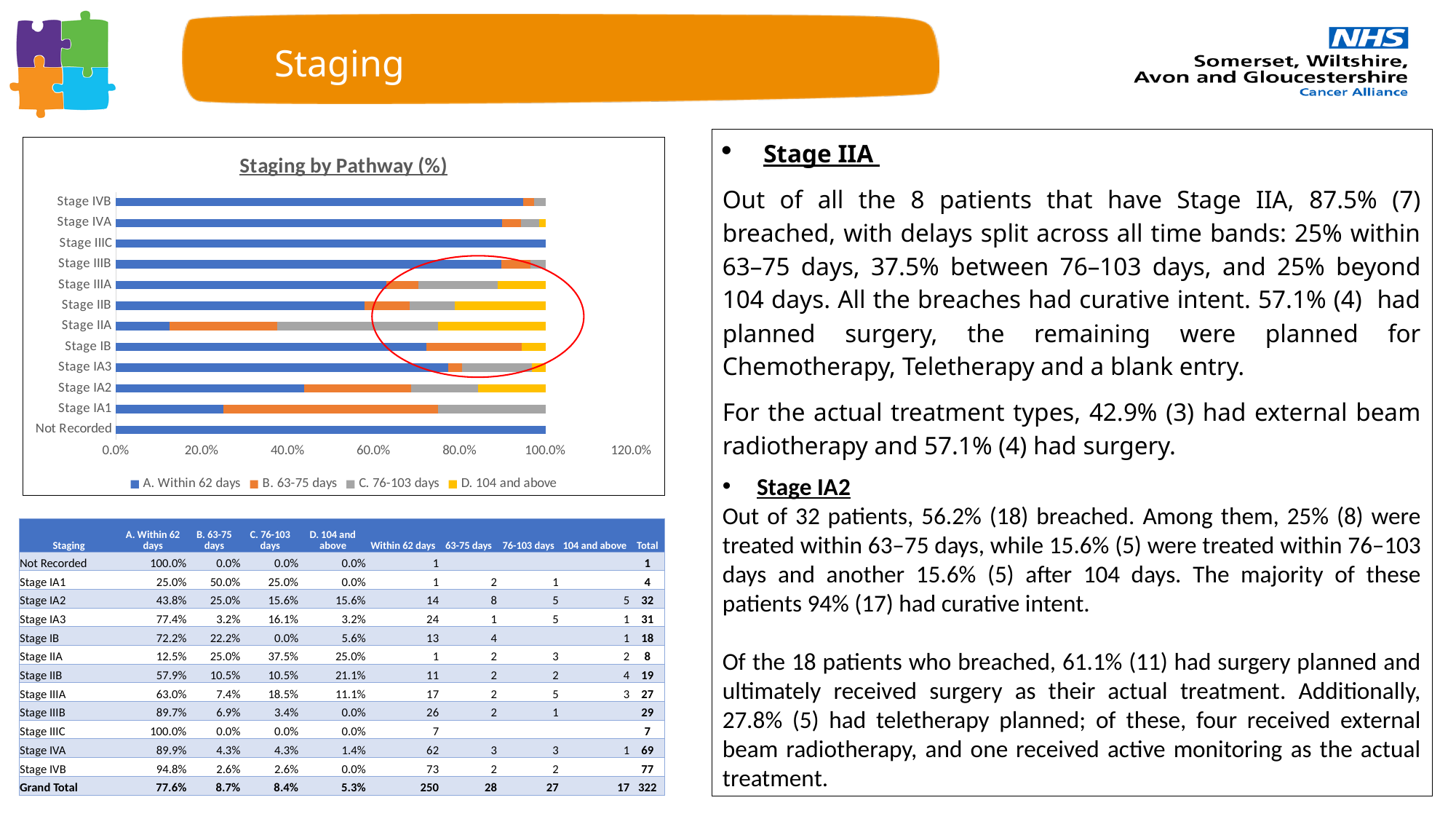
How many series does the legend of the 'Staging by Pathway (%)' chart list? 4 In the 'Staging by Pathway (%)' chart, which has the larger 'A. Within 62 days' share, Stage IA2 or Stage IA3? Stage IA3 In the 'Staging by Pathway (%)' chart, is the 'A. Within 62 days' value for Stage IIIC greater or less than 80.0%? greater How many staging categories are plotted on the y axis of the 'Staging by Pathway (%)' chart? 12 In the 'Staging by Pathway (%)' chart, is the 'A. Within 62 days' value for Stage IA1 greater or less than 40.0%? less Which colour represents 'D. 104 and above' in the 'Staging by Pathway (%)' chart? Yellow Which stage has the smallest 'A. Within 62 days' share in the 'Staging by Pathway (%)' chart? Stage IIA In the 'Staging by Pathway (%)' chart, is the 'A. Within 62 days' value for Stage IIA greater or less than 20.0%? less According to the table, what is the 'A. Within 62 days' percentage for Stage IIA? 12.5% Which stage has the largest 'B. 63-75 days' share in the 'Staging by Pathway (%)' chart? Stage IA1 What type of chart is 'Staging by Pathway (%)'? Stacked bar chart According to the table, what is the 'D. 104 and above' percentage for Stage IIB? 21.1%